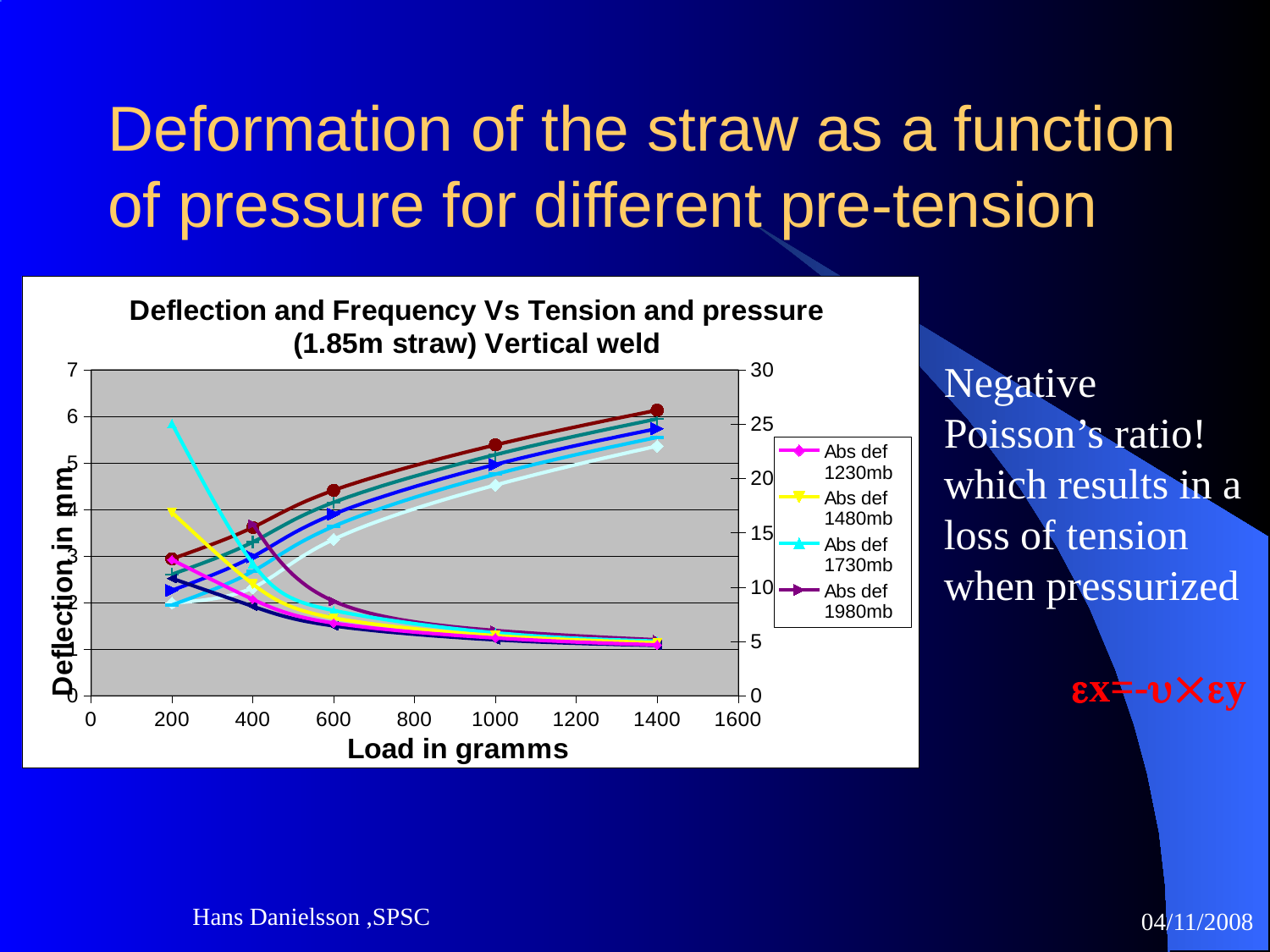
At a load of 200, which has the larger deflection: Abs def 1730mb or Abs def 1230mb? Abs def 1730mb Does the Abs def 1730mb series rise or fall as the load increases? fall What kind of chart is shown on the slide? line chart What is the label of the x axis of the chart? Load in gramms What is the highest value shown on the right-hand y axis of the chart? 30 Is the deflection for Abs def 1730mb at a load of 200 greater or less than 5 mm? greater At a load of 200, which of the Abs def series shown in the legend has the highest deflection? Abs def 1730mb Is the deflection for Abs def 1230mb at a load of 200 greater or less than 2 mm? greater Does the Abs def 1230mb series rise or fall as the load increases from 200 to 1400? fall Is the deflection for Abs def 1980mb at a load of 400 greater or less than 3 mm? greater What is the title of the chart? Deflection and Frequency Vs Tension and pressure (1.85m straw) Vertical weld